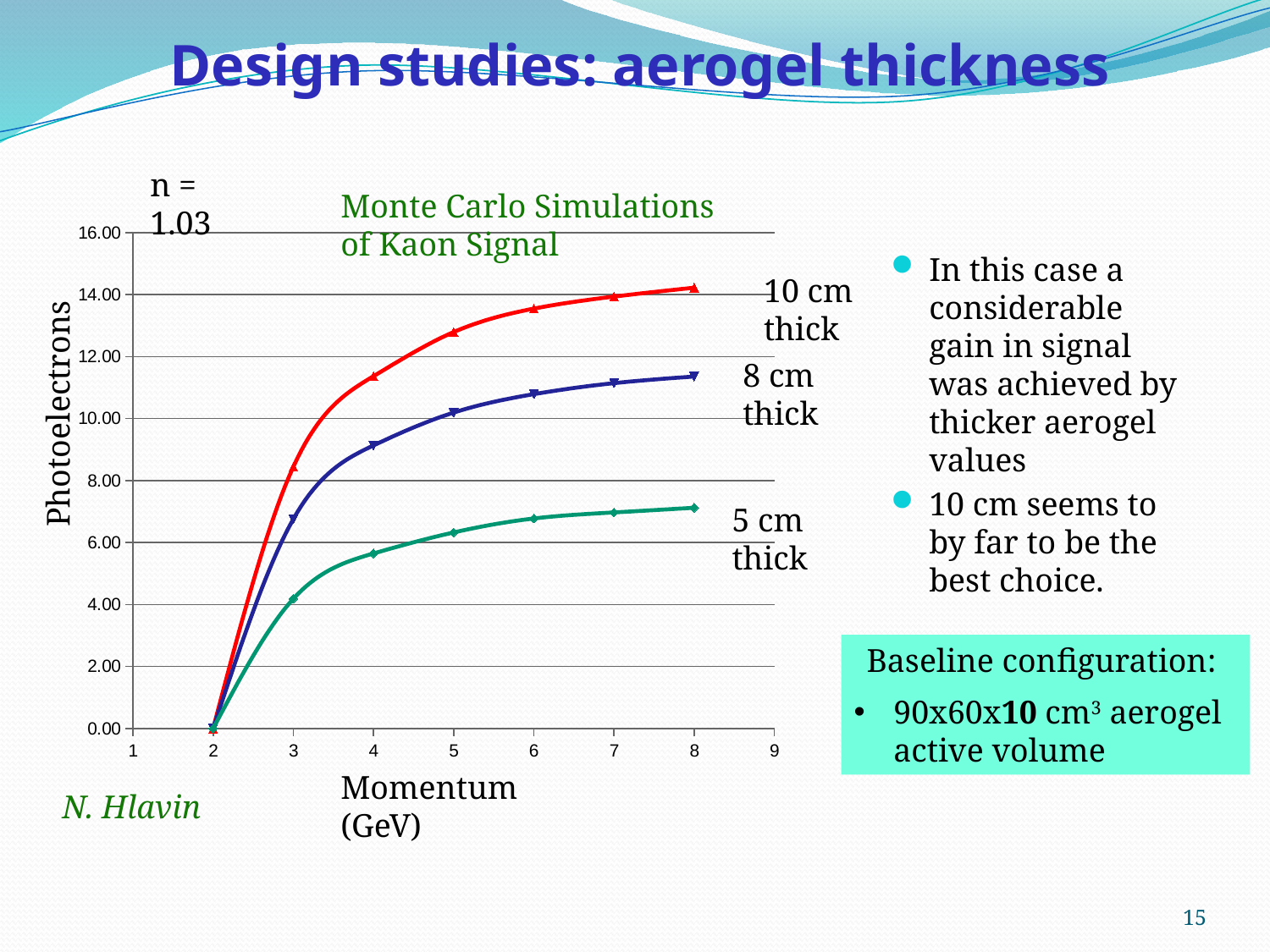
What kind of chart is shown on the slide? line chart Is the number of photoelectrons for the 5 cm thick aerogel at 8 GeV greater or less than 8.00? less Which aerogel thickness gives the lowest number of photoelectrons at a momentum of 6 GeV? 5 cm thick What is the title of the chart? Monte Carlo Simulations of Kaon Signal How many momentum points are plotted for each series on the chart? 7 At a momentum of 4 GeV, which gives more photoelectrons: the 10 cm thick or the 8 cm thick aerogel? 10 cm thick What is the label of the y axis of the chart? Photoelectrons Does the number of photoelectrons for the 8 cm thick aerogel rise or fall as momentum increases from 2 to 8 GeV? rise Which aerogel thickness gives the highest number of photoelectrons at a momentum of 8 GeV? 10 cm thick Is the number of photoelectrons for the 10 cm thick aerogel at 5 GeV greater or less than 12.00? greater How many series (aerogel thicknesses) are plotted on the chart? 3 Is the number of photoelectrons for the 8 cm thick aerogel at 8 GeV greater or less than 10.00? greater